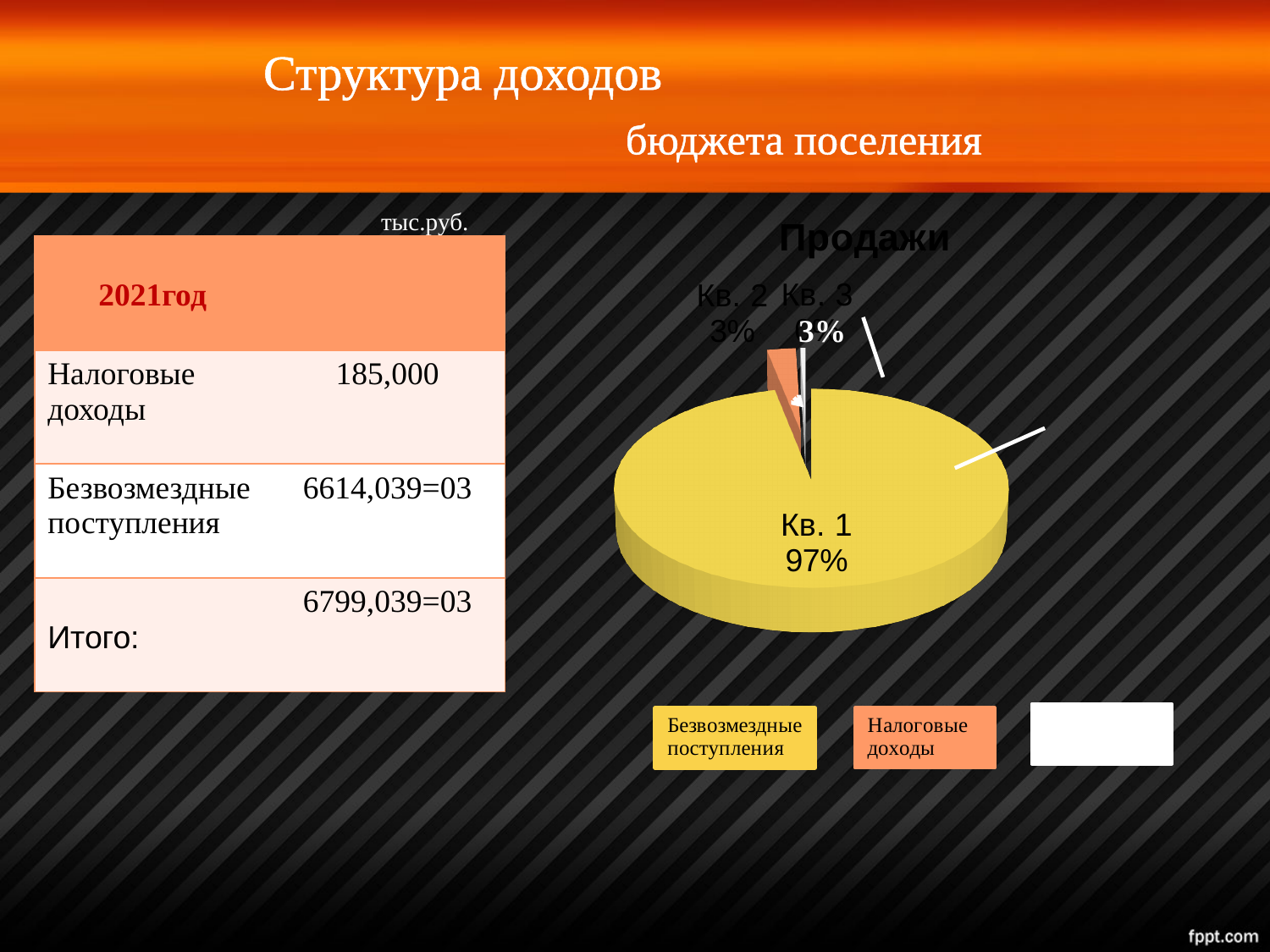
By how many percentage points does the Кв. 1 share exceed the Кв. 2 share? 94 Which legend entry is shown with the yellow colour that matches the largest slice? Безвозмездные поступления Which is larger in the pie chart, Кв. 1 or Кв. 2? Кв. 1 What share of the pie does Кв. 1 have? 97% What share of the pie does Кв. 2 have? 3% How many slices are labelled in the pie chart? 3 What kind of chart is shown on the slide? pie chart Which slice of the pie chart is the largest? Кв. 1 What is the title of the pie chart? Продажи Is the share for Кв. 1 greater or less than 50%? greater